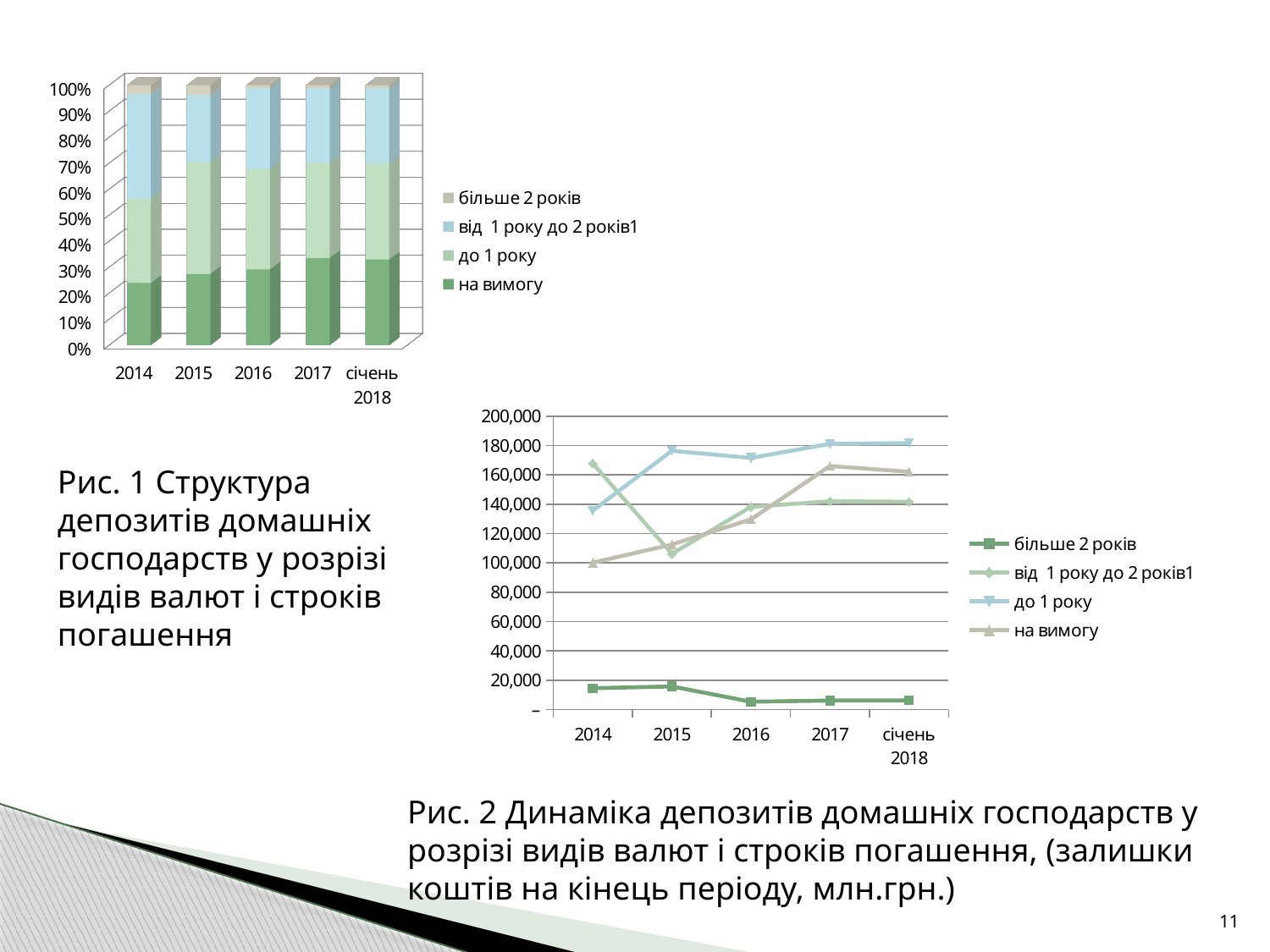
In Рис. 2, which is larger in 2014: 'від 1 року до 2 років1' or 'до 1 року'? від 1 року до 2 років1 In Рис. 1, is the share of 'на вимогу' in 2014 greater or less than 30%? less In Рис. 2, is the value for 'до 1 року' in 2017 greater or less than 160,000? greater In Рис. 2, how many series does the legend list? 4 What kind of chart is Рис. 1 (the top-left chart)? bar chart In Рис. 2, which series has the highest value in січень 2018? до 1 року In Рис. 1, how many bars are shown? 5 In Рис. 2, which series has the lowest value in 2014? більше 2 років In Рис. 2, does the 'на вимогу' series rise or fall from 2014 to 2017? rise What kind of chart is Рис. 2 (the bottom-right chart)? line chart In Рис. 2, how many periods are shown on the x axis? 5 In Рис. 2, is the value for 'більше 2 років' in 2016 greater or less than 20,000? less